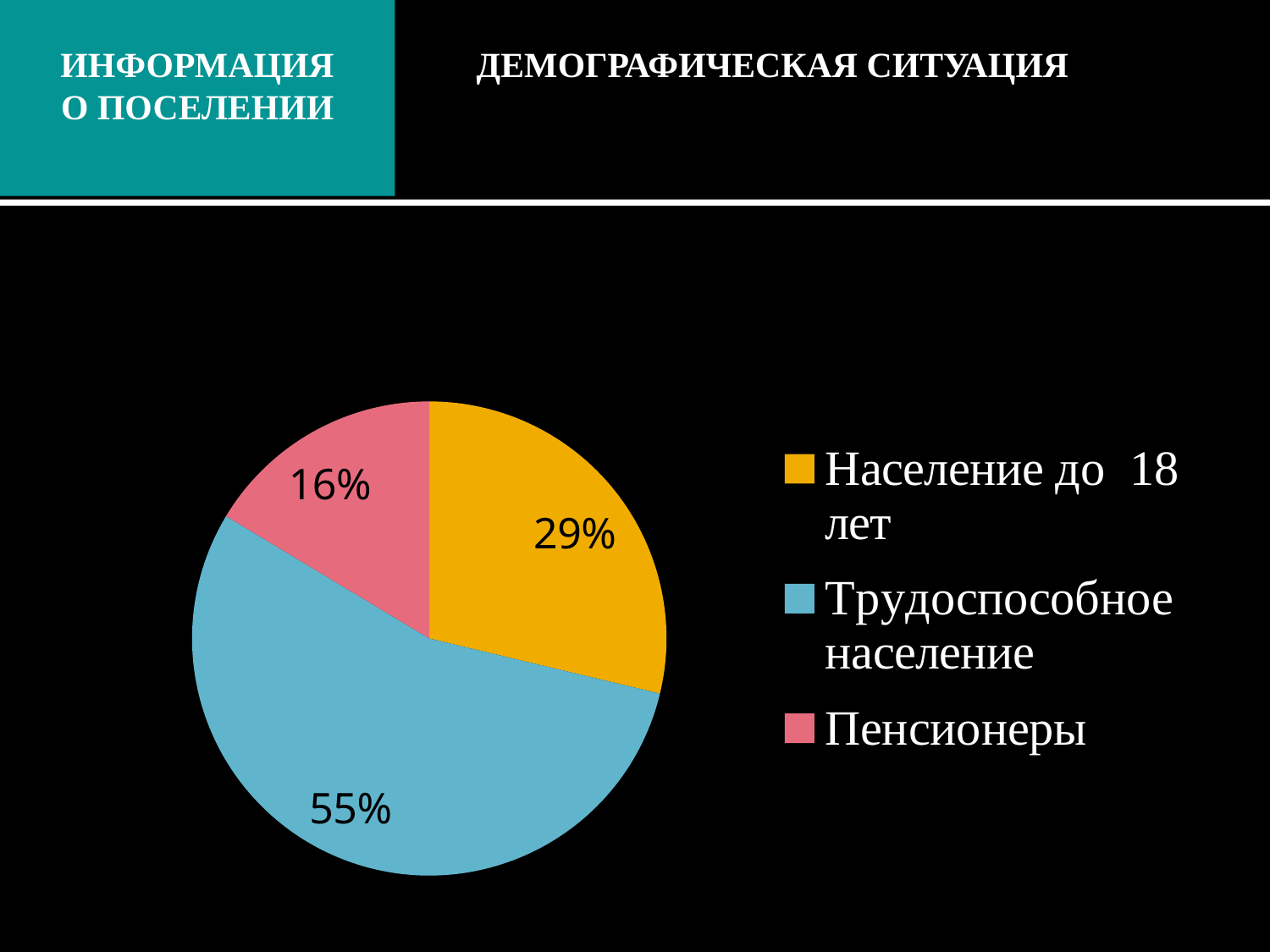
What is the title of the chart section on the slide? ДЕМОГРАФИЧЕСКАЯ СИТУАЦИЯ Which is larger, the slice for Население до 18 лет or the slice for Пенсионеры? Население до 18 лет How many slices does the pie chart have? 3 What share of the pie does Трудоспособное население have? 55% What share of the pie does Население до 18 лет have? 29% What share of the pie does Пенсионеры have? 16% Which category has the largest slice of the pie? Трудоспособное население What colour is the slice for Пенсионеры? Pink What is the difference in percentage points between Население до 18 лет and Пенсионеры? 13 What kind of chart is shown on the slide? Pie chart Which category has the smallest slice of the pie? Пенсионеры What is the difference in percentage points between Трудоспособное население and Население до 18 лет? 26